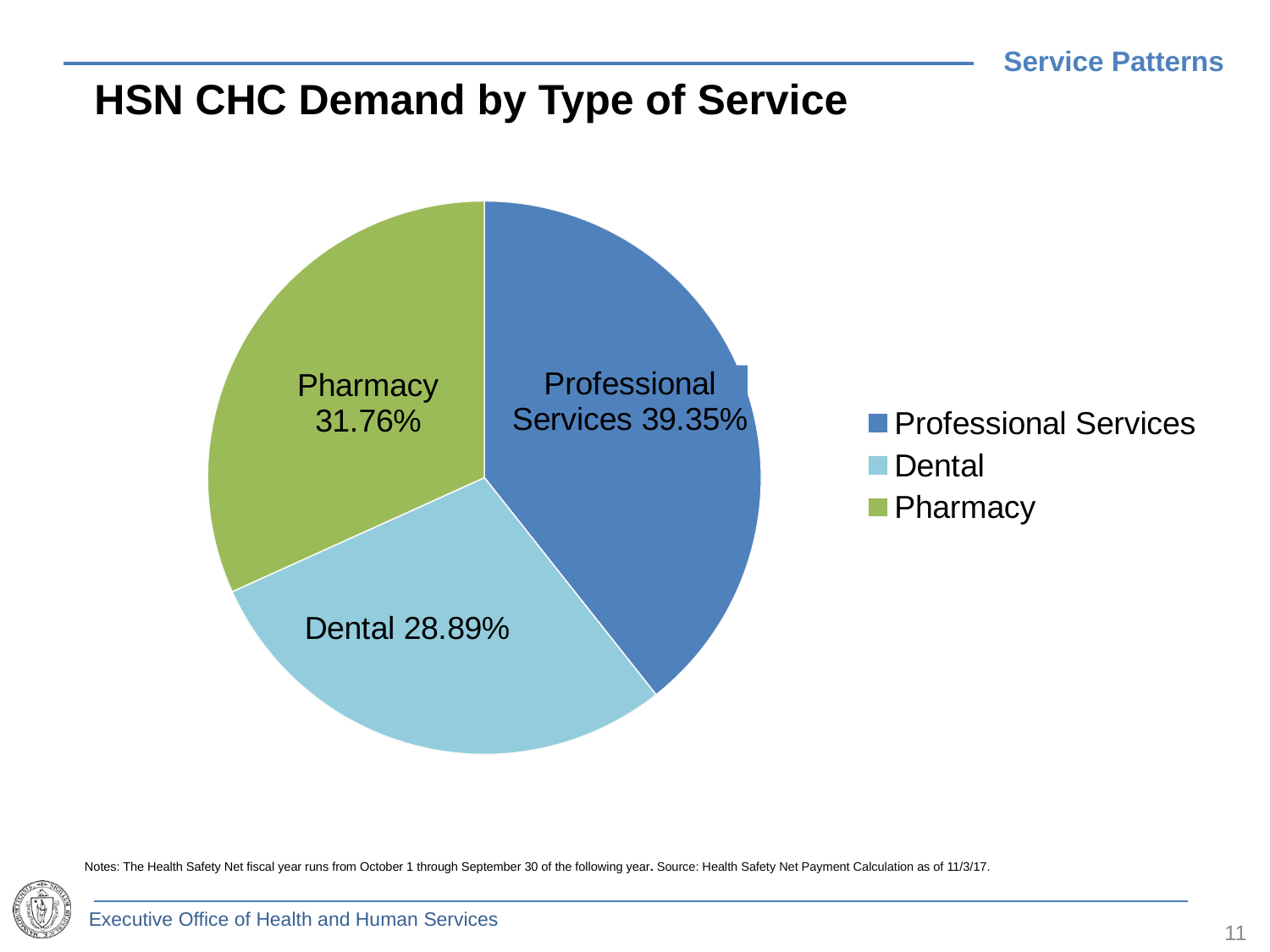
How many slices does the pie chart have? 3 What is the title of the chart on the slide? HSN CHC Demand by Type of Service How many entries does the legend list? 3 Which type of service has the smallest share of HSN CHC demand? Dental Which type of service has the largest share of HSN CHC demand? Professional Services What share of HSN CHC demand is Pharmacy? 31.76% What is the difference in percentage points between the Professional Services share and the Dental share? 10.46 What is the difference in percentage points between the Pharmacy share and the Dental share? 2.87 What kind of chart is shown on the slide? Pie chart What share of HSN CHC demand is Dental? 28.89% What share of HSN CHC demand is Professional Services? 39.35% Which has a larger share of HSN CHC demand, Pharmacy or Dental? Pharmacy